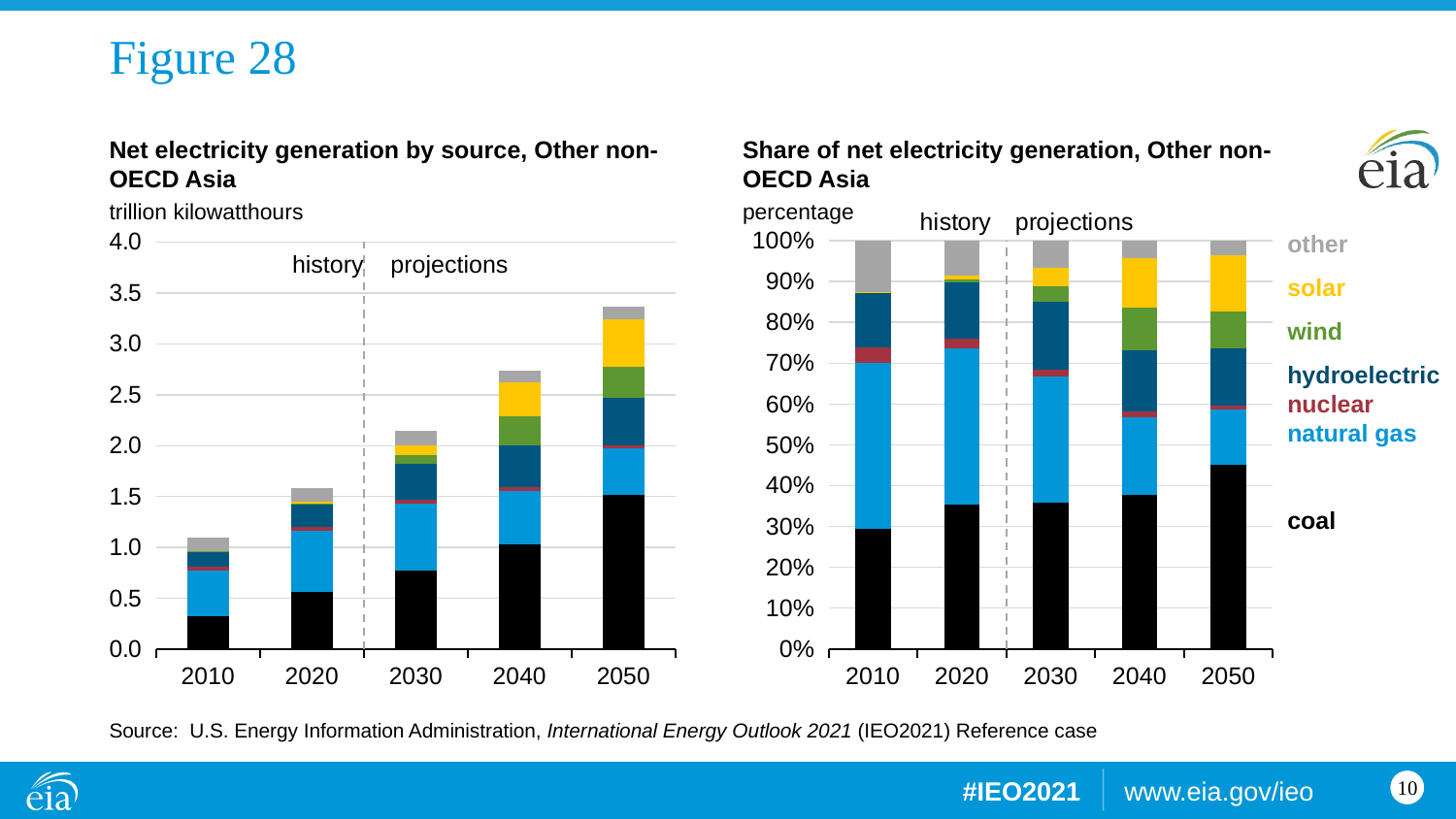
What kind of chart is the left chart, 'Net electricity generation by source, Other non-OECD Asia'? stacked bar chart In the right chart, 'Share of net electricity generation, Other non-OECD Asia', does the coal share rise or fall from 2010 to 2050? rise In the right chart, 'Share of net electricity generation, Other non-OECD Asia', is the coal share in 2050 greater or less than 40%? greater How many years are shown on the x axis of the left chart, 'Net electricity generation by source, Other non-OECD Asia'? 5 In the left chart, 'Net electricity generation by source, Other non-OECD Asia', which year has the tallest total bar? 2050 How many sources does the legend of the right chart, 'Share of net electricity generation, Other non-OECD Asia', list? 7 In the left chart, 'Net electricity generation by source, Other non-OECD Asia', is the coal segment for 2050 greater or less than 1.0 trillion kilowatthours? greater What unit is shown under the title of the left chart, 'Net electricity generation by source, Other non-OECD Asia'? trillion kilowatthours In the left chart, 'Net electricity generation by source, Other non-OECD Asia', is the total bar for 2050 greater or less than 3.0 trillion kilowatthours? greater In the left chart, 'Net electricity generation by source, Other non-OECD Asia', do the total bars rise or fall from 2010 to 2050? rise In the left chart, 'Net electricity generation by source, Other non-OECD Asia', which year has the shortest total bar? 2010